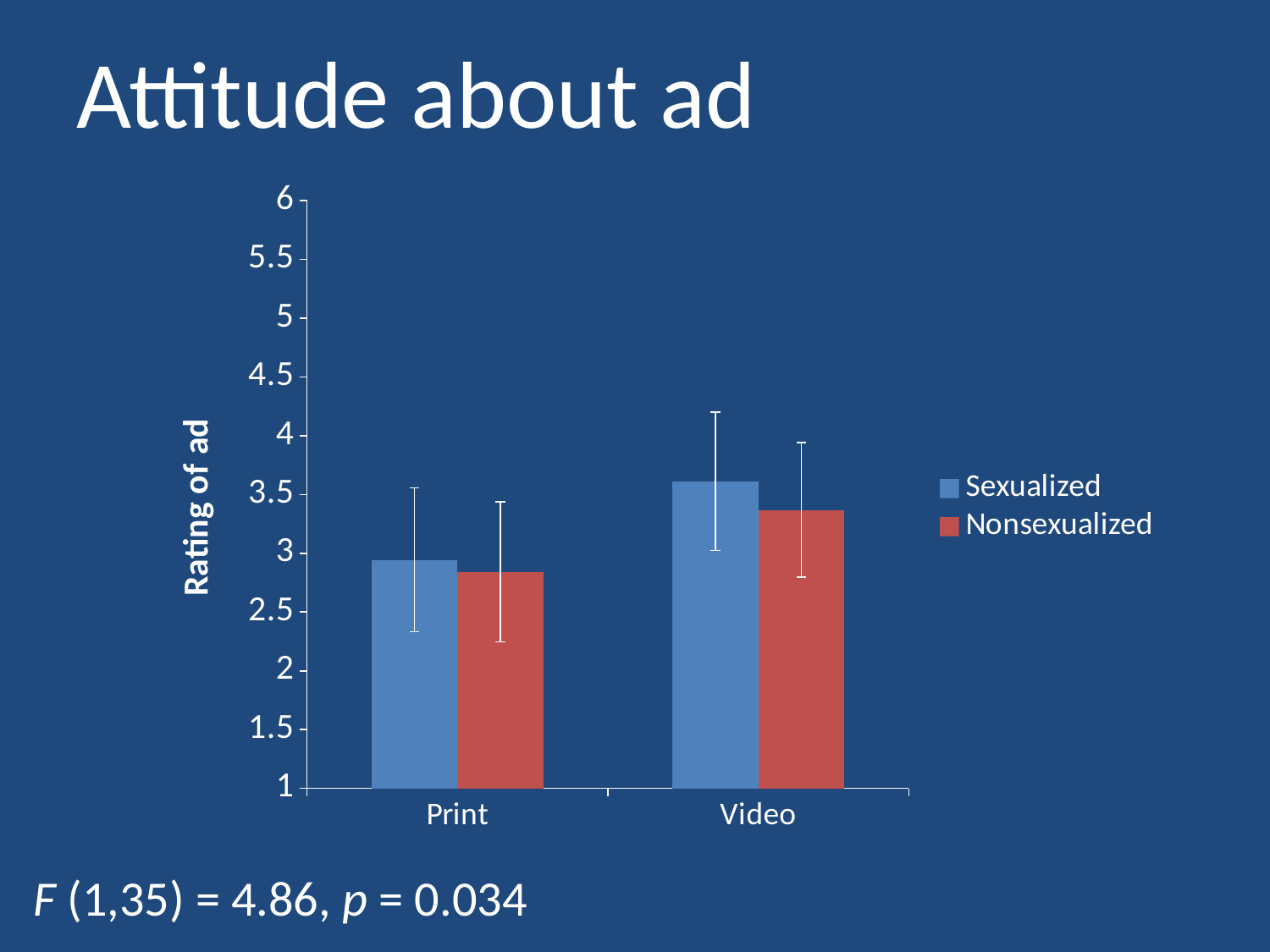
Which category has the highest Nonsexualized bar? Video Is the Nonsexualized value for Video greater or less than 3? greater Is the Sexualized value for Print greater or less than 3.5? less Which is larger, the Sexualized bar for Print or the Sexualized bar for Video? Video Do the Sexualized values rise or fall from Print to Video? rise What kind of chart is shown on the slide? bar chart How many categories are shown on the x axis? 2 What is the title of the y axis? Rating of ad Which category has the highest Sexualized bar? Video How many series does the legend list? 2 Which is larger, the Nonsexualized bar for Print or the Nonsexualized bar for Video? Video For Video, which is larger, the Sexualized bar or the Nonsexualized bar? Sexualized